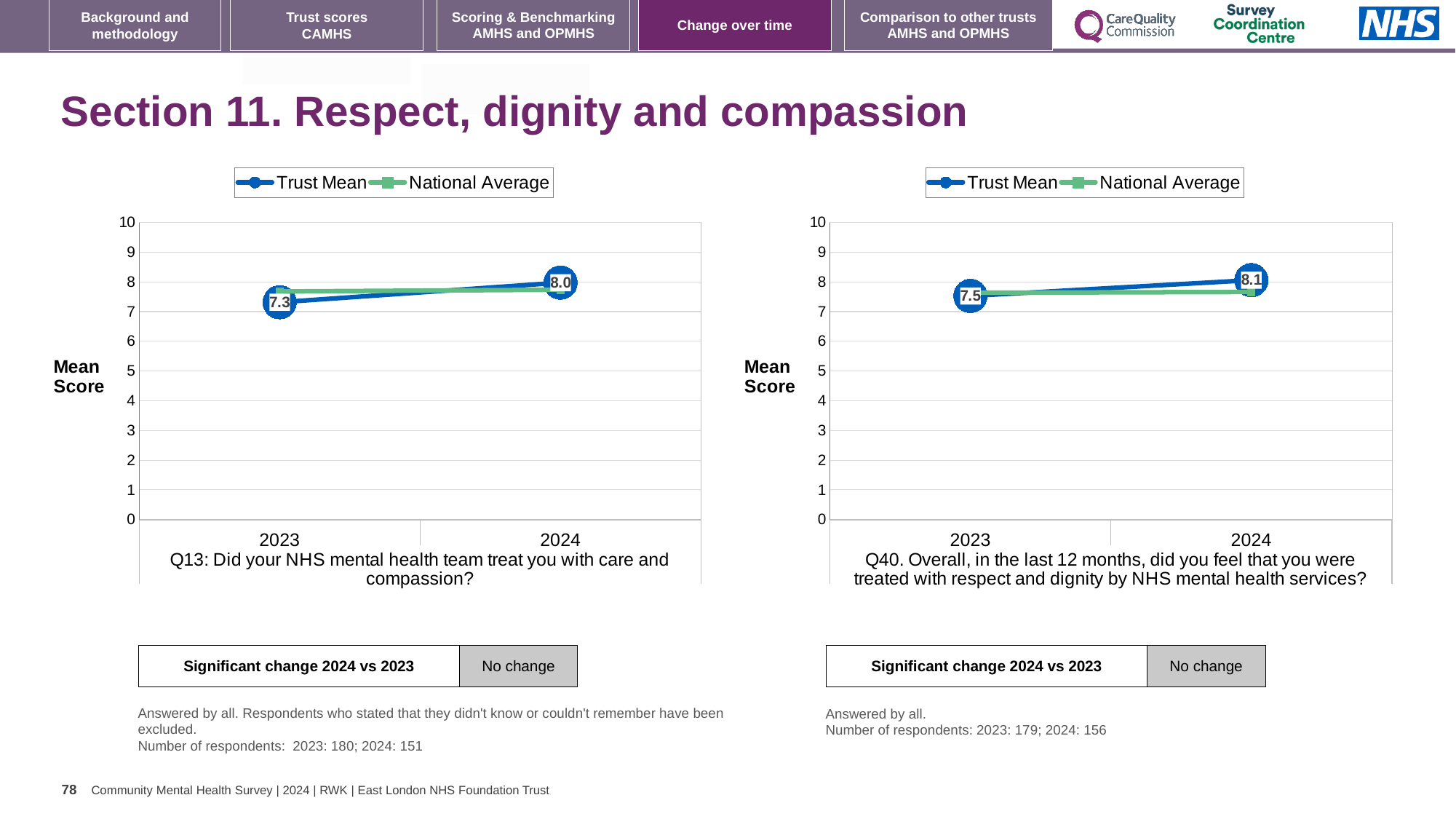
On the left chart (Q13), what is the Trust Mean for 2024? 8.0 On the right chart (Q40), what is the Trust Mean for 2024? 8.1 On the left chart (Q13), by how much did the Trust Mean change from 2023 to 2024? 0.7 On the left chart (Q13), what is the Trust Mean for 2023? 7.3 On the right chart (Q40), what is the Trust Mean for 2023? 7.5 What kind of chart is the left chart (Q13)? line chart On the right chart (Q40), what is the difference between the Trust Mean in 2024 and 2023? 0.6 On the left chart (Q13), is the National Average for 2023 greater or less than 7? greater How many series does the legend of the right chart (Q40) list? 2 How many years are shown on the x axis of the left chart (Q13)? 2 On the right chart (Q40), does the Trust Mean rise or fall from 2023 to 2024? rise On the right chart (Q40), which is larger in 2024, the Trust Mean or the National Average? Trust Mean